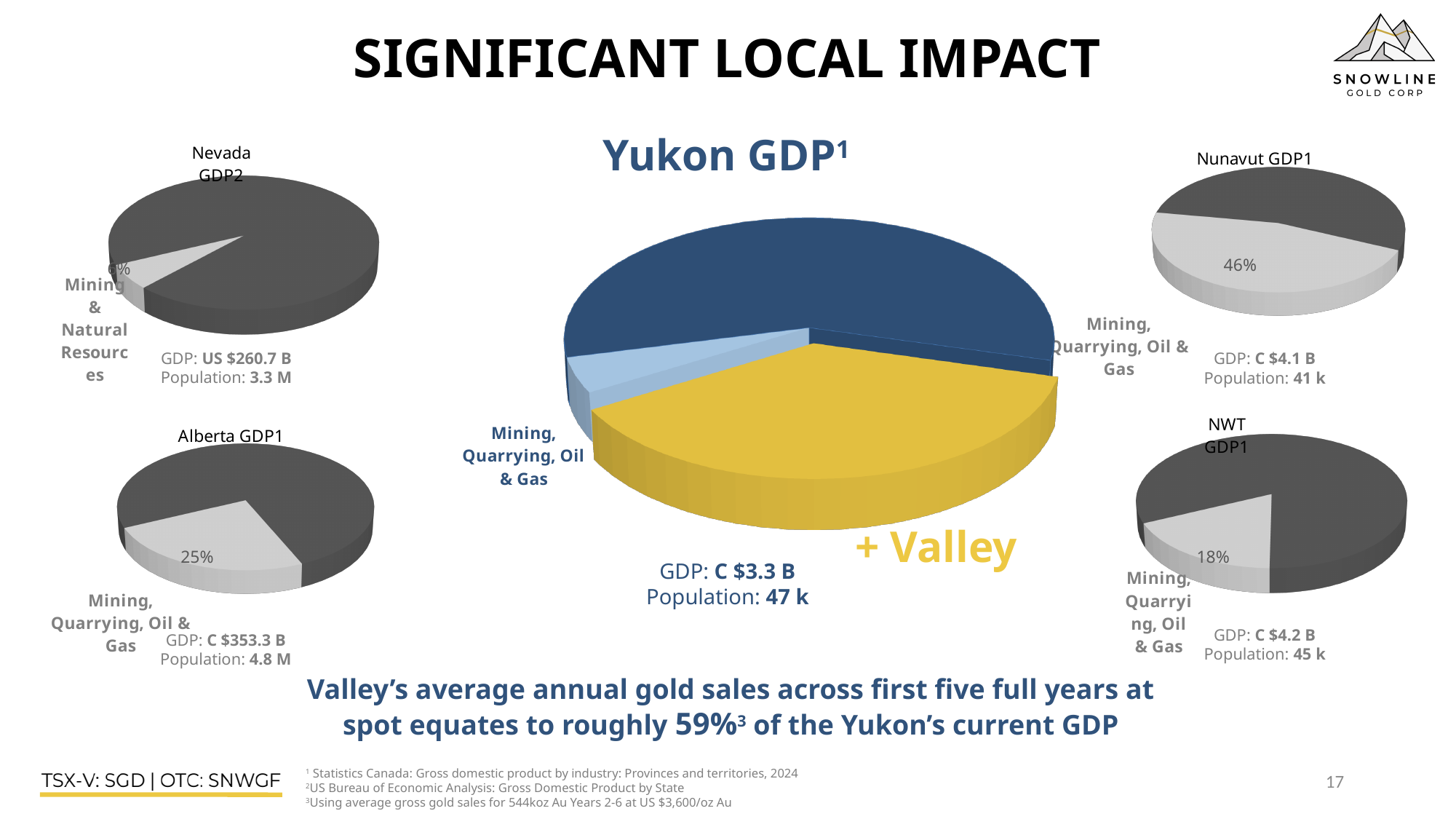
In the NWT GDP1 pie chart, what percentage is shown for the Mining, Quarrying, Oil & Gas slice? 18% In the Nunavut GDP1 pie chart, what percentage is shown for the Mining, Quarrying, Oil & Gas slice? 46% In the Alberta GDP1 pie chart, what share is labelled for Mining, Quarrying, Oil & Gas? 25% What kind of chart is used for the Yukon GDP chart in the centre of the slide? Pie chart Comparing the Nunavut GDP1 and NWT GDP1 charts, which has the larger Mining, Quarrying, Oil & Gas share? Nunavut How many pie charts are shown on the slide? 5 Comparing the Alberta GDP1 and NWT GDP1 charts, which has the larger Mining, Quarrying, Oil & Gas share? Alberta Among the Nevada, Alberta, Nunavut and NWT pie charts, which region shows the highest mining share? Nunavut What is the difference between the Mining, Quarrying, Oil & Gas share in the Nunavut GDP1 chart and the Alberta GDP1 chart? 21% Among the Nevada, Alberta, Nunavut and NWT pie charts, which region shows the lowest mining share? Nevada In the Yukon GDP chart, what colour is the slice labelled '+ Valley'? Yellow